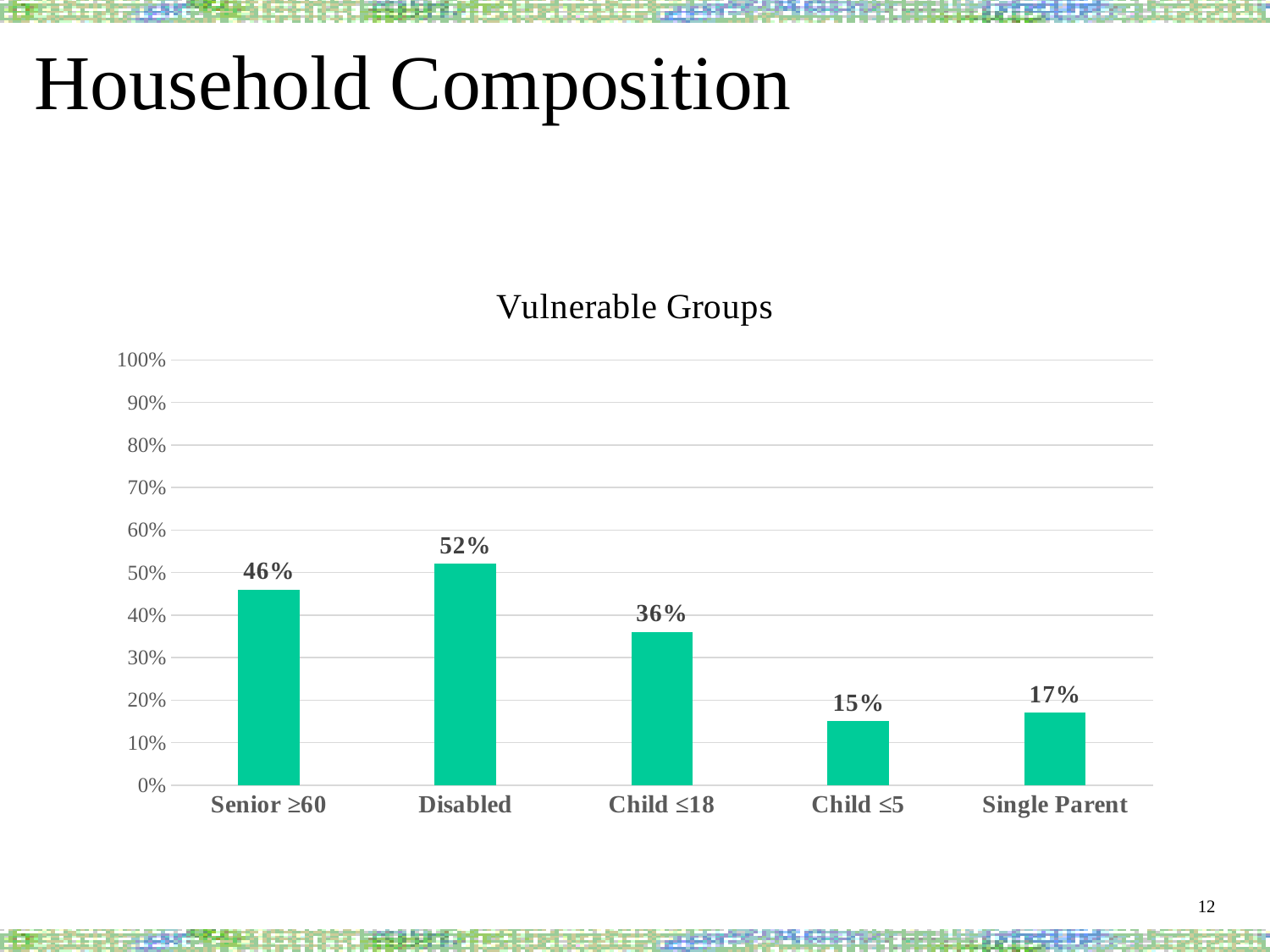
What is the difference between the values for Disabled and Senior ≥60? 6% What is the value for Child ≤5? 15% How many categories are shown on the x axis? 5 What is the value for Disabled? 52% Which category has the highest value? Disabled What is the difference between the values for Child ≤18 and Child ≤5? 21% What is the value for Single Parent? 17% Which category has the lowest value? Child ≤5 What is the title of the chart? Vulnerable Groups What kind of chart is shown? bar chart Which is larger, the value for Senior ≥60 or the value for Child ≤18? Senior ≥60 Is the value for Child ≤18 greater or less than 30%? greater